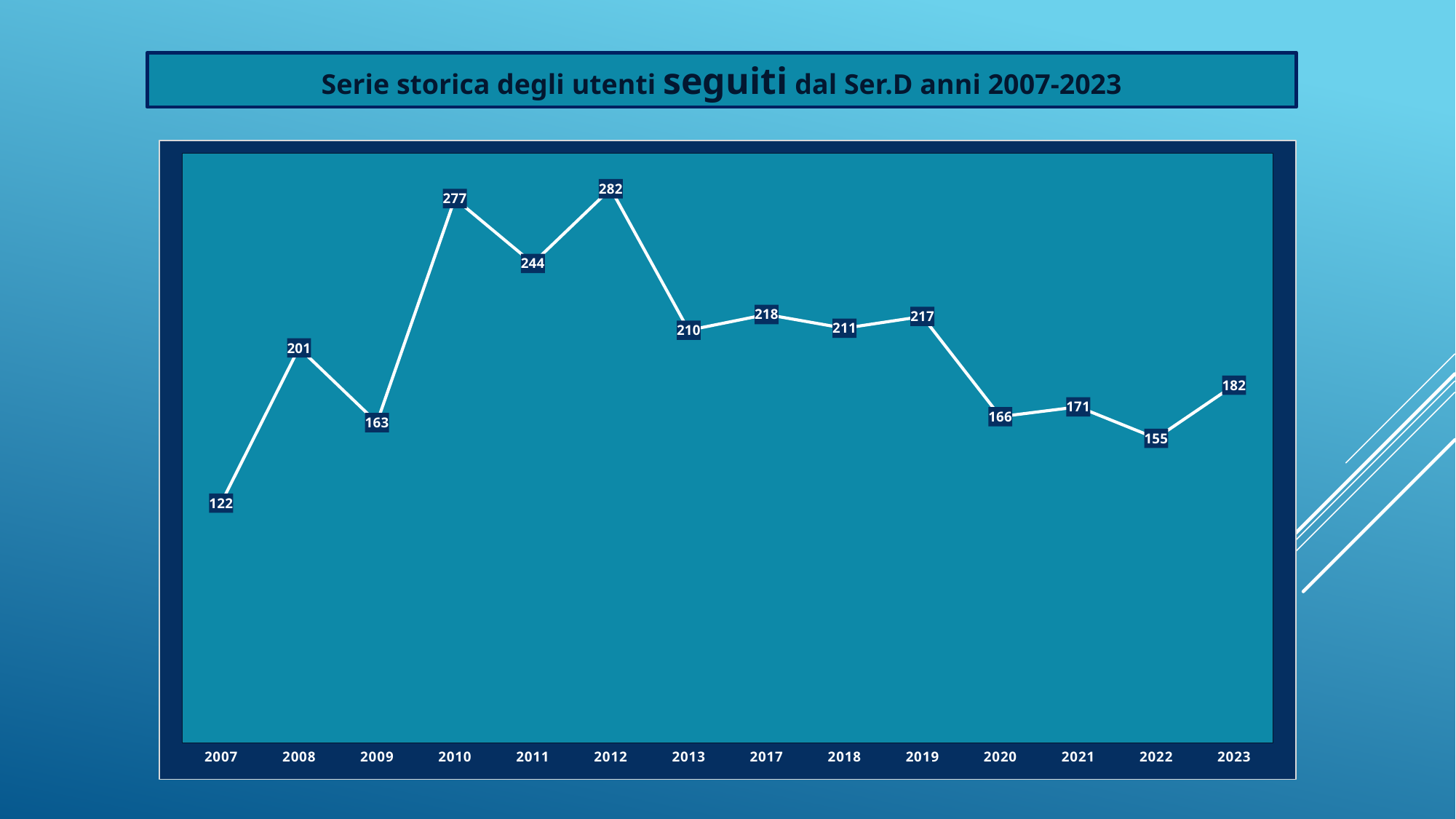
How many years are plotted on the x axis? 14 Which year has the lowest value? 2007 Which year has the highest value? 2012 Which is larger, the value for 2020 or the value for 2021? 2021 What kind of chart is shown? line chart What is the value for 2018? 211 What is the difference between the values for 2012 and 2013? 72 What is the title of the chart? Serie storica degli utenti seguiti dal Ser.D anni 2007-2023 What is the value for 2010? 277 What is the difference between the values for 2008 and 2009? 38 Do the values rise or fall from 2019 to 2020? fall What is the value for 2023? 182